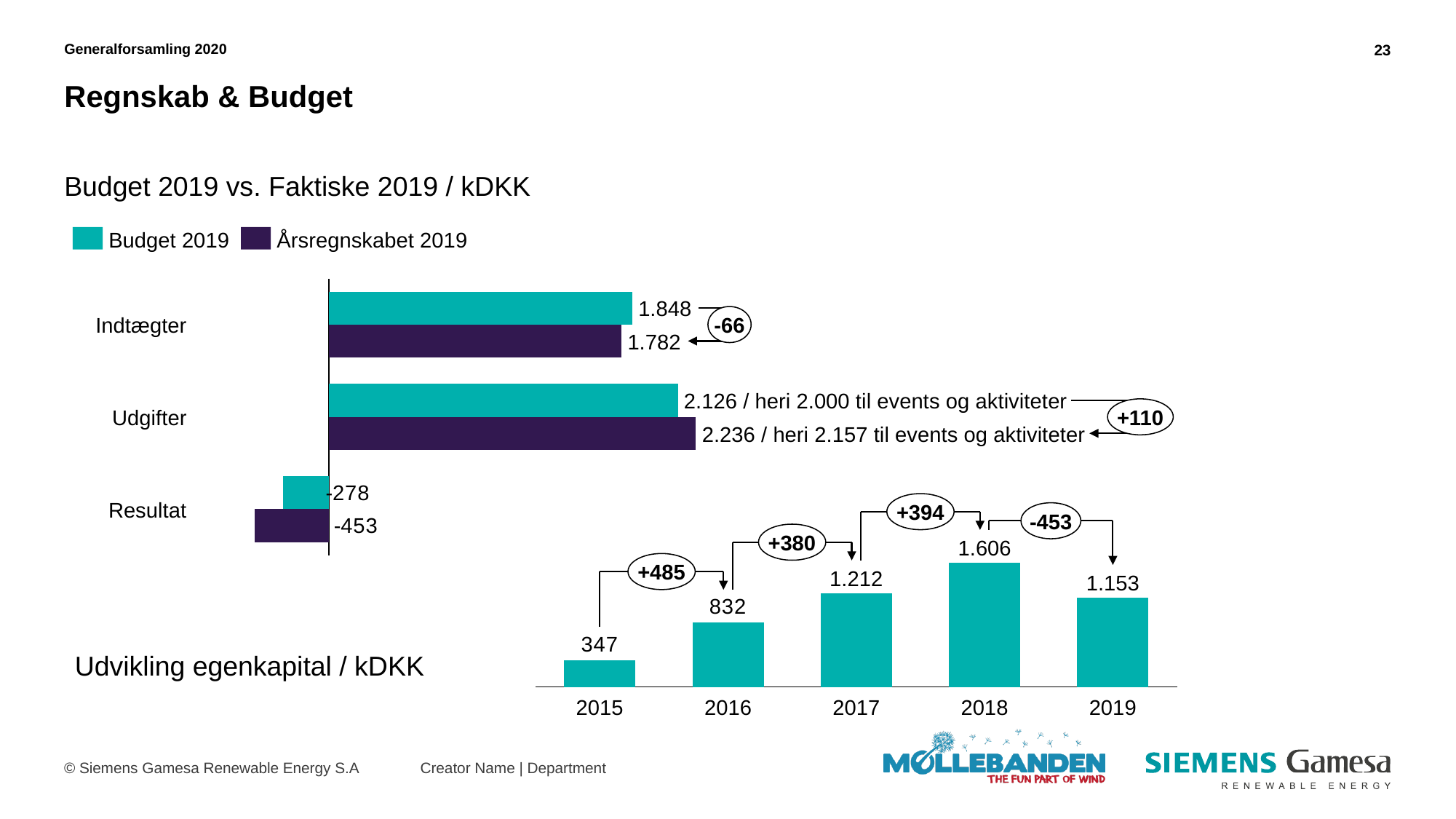
What kind of chart is the 'Budget 2019 vs. Faktiske 2019 / kDKK' chart? Bar chart How many series does the legend of the 'Budget 2019 vs. Faktiske 2019 / kDKK' chart list? 2 In the 'Budget 2019 vs. Faktiske 2019 / kDKK' chart, which is larger for Udgifter: Budget 2019 or Årsregnskabet 2019? Årsregnskabet 2019 How many years are shown in the 'Udvikling egenkapital / kDKK' chart? 5 In the 'Udvikling egenkapital / kDKK' chart, what is the value for 2017? 1.212 In the 'Udvikling egenkapital / kDKK' chart, which year has the lowest value? 2015 In the 'Budget 2019 vs. Faktiske 2019 / kDKK' chart, what is the Årsregnskabet 2019 value for Resultat? -453 In the 'Budget 2019 vs. Faktiske 2019 / kDKK' chart, what is the difference between the Budget 2019 and Årsregnskabet 2019 values for Indtægter? 66 In the 'Budget 2019 vs. Faktiske 2019 / kDKK' chart, what is the Budget 2019 value for Indtægter? 1.848 In the 'Udvikling egenkapital / kDKK' chart, which year has the highest value? 2018 In the 'Budget 2019 vs. Faktiske 2019 / kDKK' chart, what is the Årsregnskabet 2019 value for Udgifter? 2.236 In the 'Udvikling egenkapital / kDKK' chart, what is the difference between the 2018 and 2019 values? 453